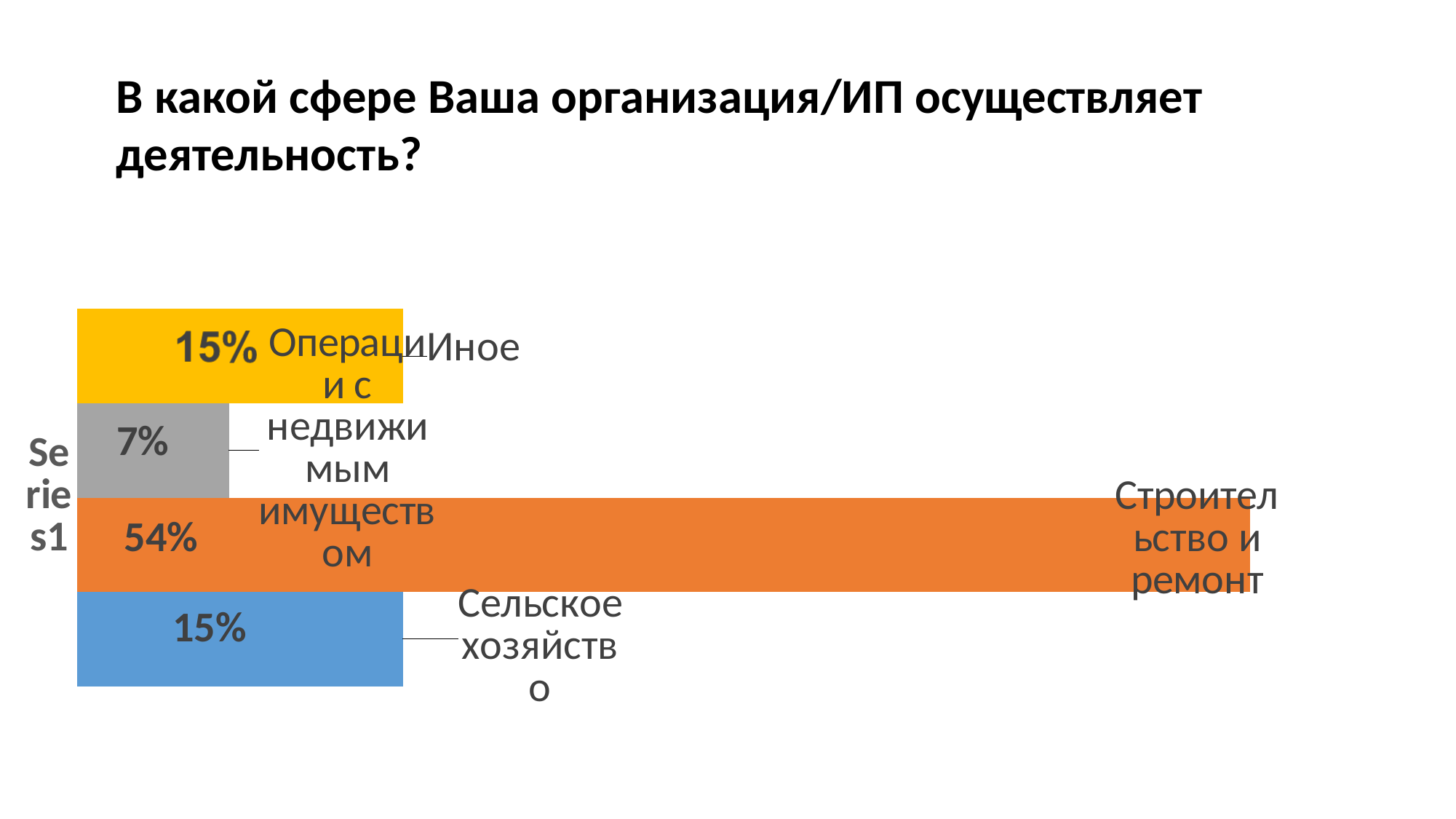
How many categories are shown in the chart? 4 What type of chart is shown on the slide? Bar chart Which is larger, the value for Строительство и ремонт or the value for Операции с недвижимым имуществом? Строительство и ремонт What is the value for Иное? 15% What is the value for Строительство и ремонт? 54% What is the difference between the values for Строительство и ремонт and Сельское хозяйство? 39% What is the value for Сельское хозяйство? 15% What is the difference between the values for Иное and Операции с недвижимым имуществом? 8% What is the value for Операции с недвижимым имуществом? 7% Which category has the highest value? Строительство и ремонт What is the title of the slide above the chart? В какой сфере Ваша организация/ИП осуществляет деятельность? Which category has the lowest value? Операции с недвижимым имуществом